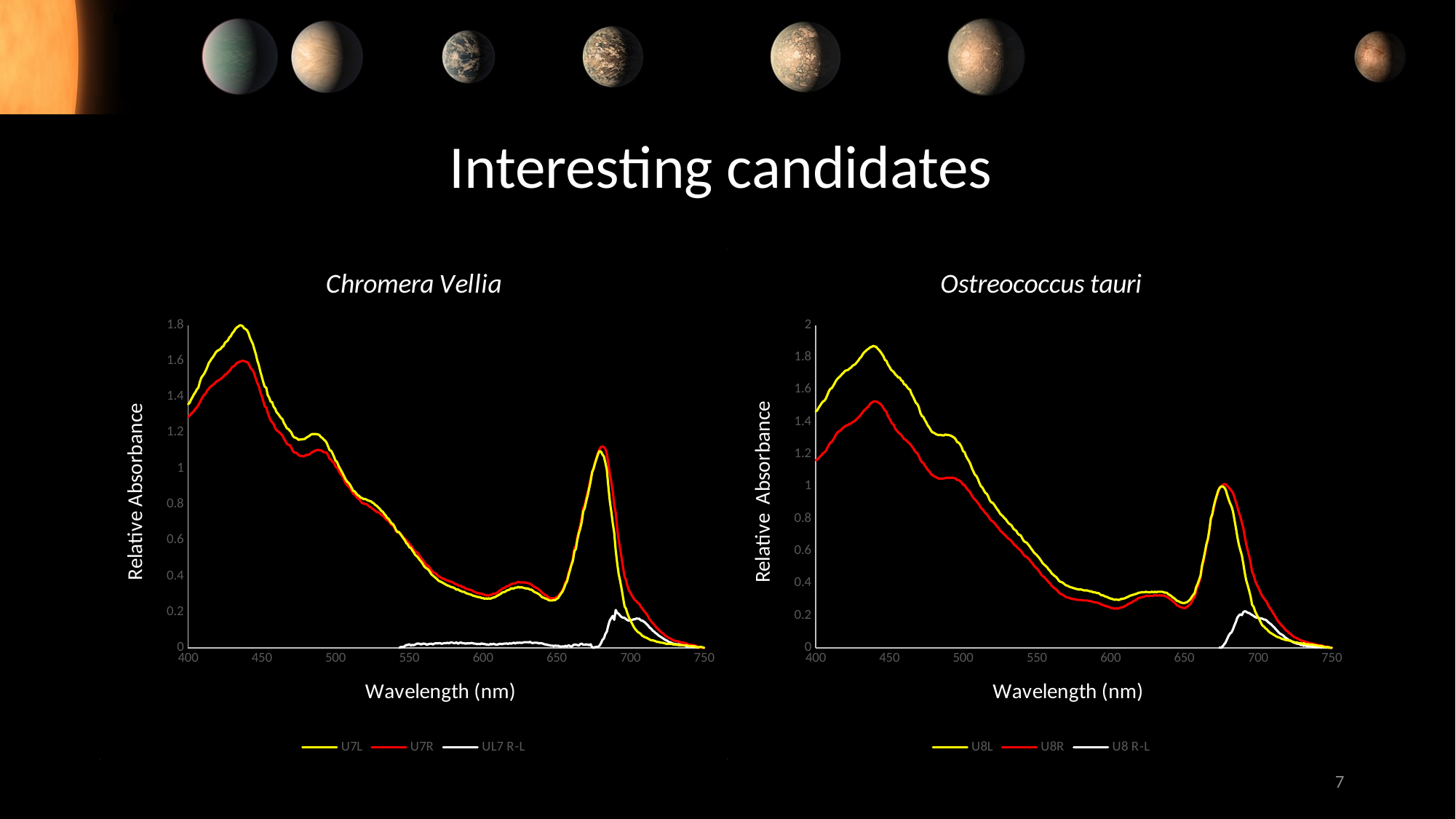
In the Ostreococcus tauri chart, is the value of U8L at 550 nm greater or less than 1? less In the Chromera Vellia chart, which series reaches the higher peak near 440 nm, U7L or U7R? U7L How many series does the legend of the Ostreococcus tauri chart list? 3 In the Chromera Vellia chart, does the U7L series rise or fall between 450 nm and 600 nm? fall In the Chromera Vellia chart, what are the three series named in the legend? U7L, U7R, UL7 R-L In the Chromera Vellia chart, is the value of U7L at 600 nm greater or less than 0.6? less In the Chromera Vellia chart, is the value of UL7 R-L at 600 nm greater or less than 0.2? less In the Ostreococcus tauri chart, which series has the higher value at 700 nm, U8L or U8R? U8R What is the x-axis title of the Ostreococcus tauri chart? Wavelength (nm) In the Ostreococcus tauri chart, which series reaches the highest value overall? U8L What kind of chart is the Chromera Vellia chart? line chart